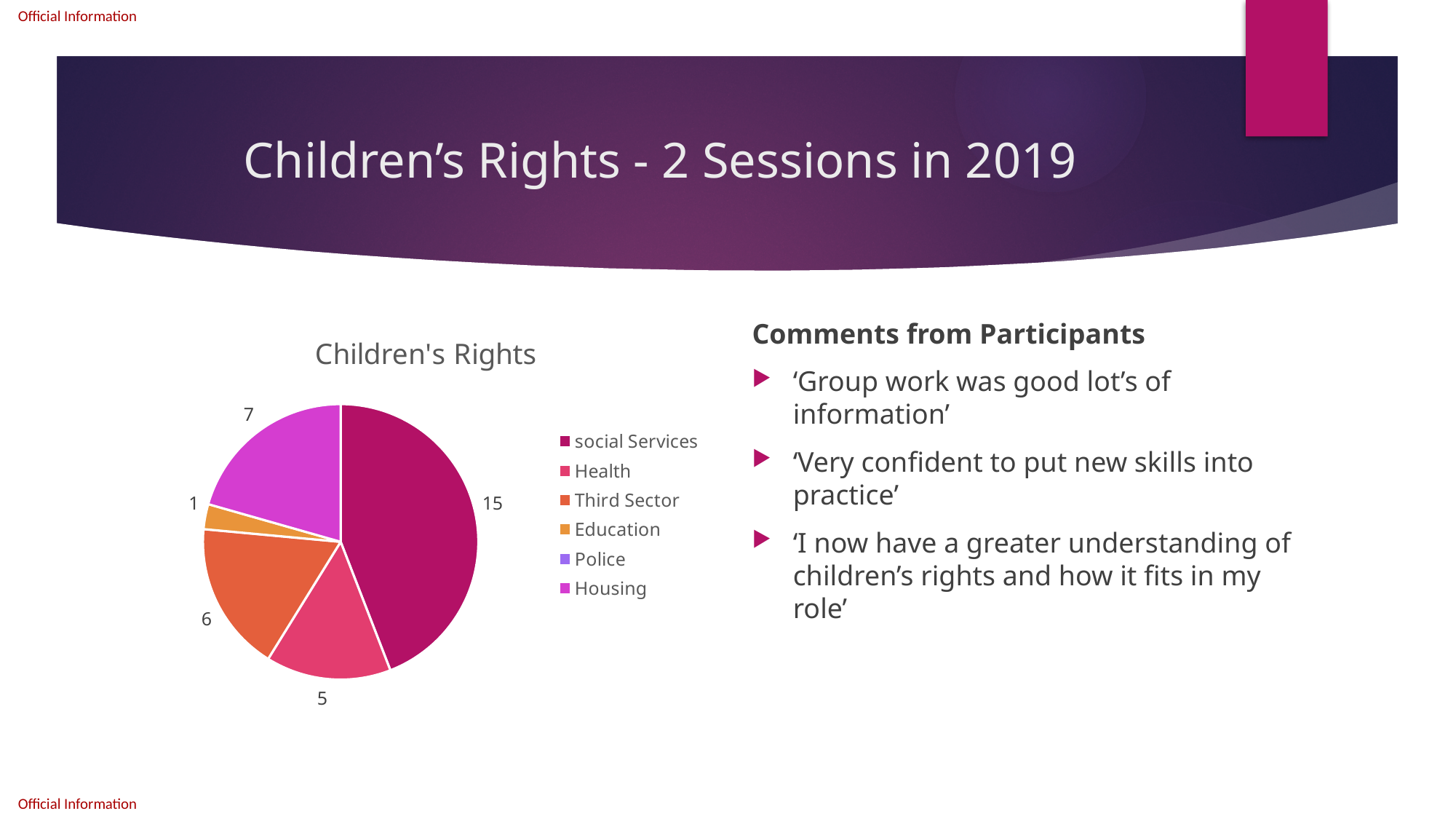
What is the difference between the values for Third Sector and Health? 1 What is the value for Health in the pie chart? 5 What is the value for Third Sector in the pie chart? 6 Which category has the largest slice in the pie chart? social Services What is the value for social Services in the pie chart? 15 How many categories does the legend of the pie chart list? 6 What is the value for Housing in the pie chart? 7 Which of the labelled slices in the pie chart is the smallest? Education What kind of chart is shown on the slide? Pie chart What is the difference between the values for social Services and Housing? 8 Which is larger, the value for Housing or the value for Third Sector? Housing What is the value for Education in the pie chart? 1